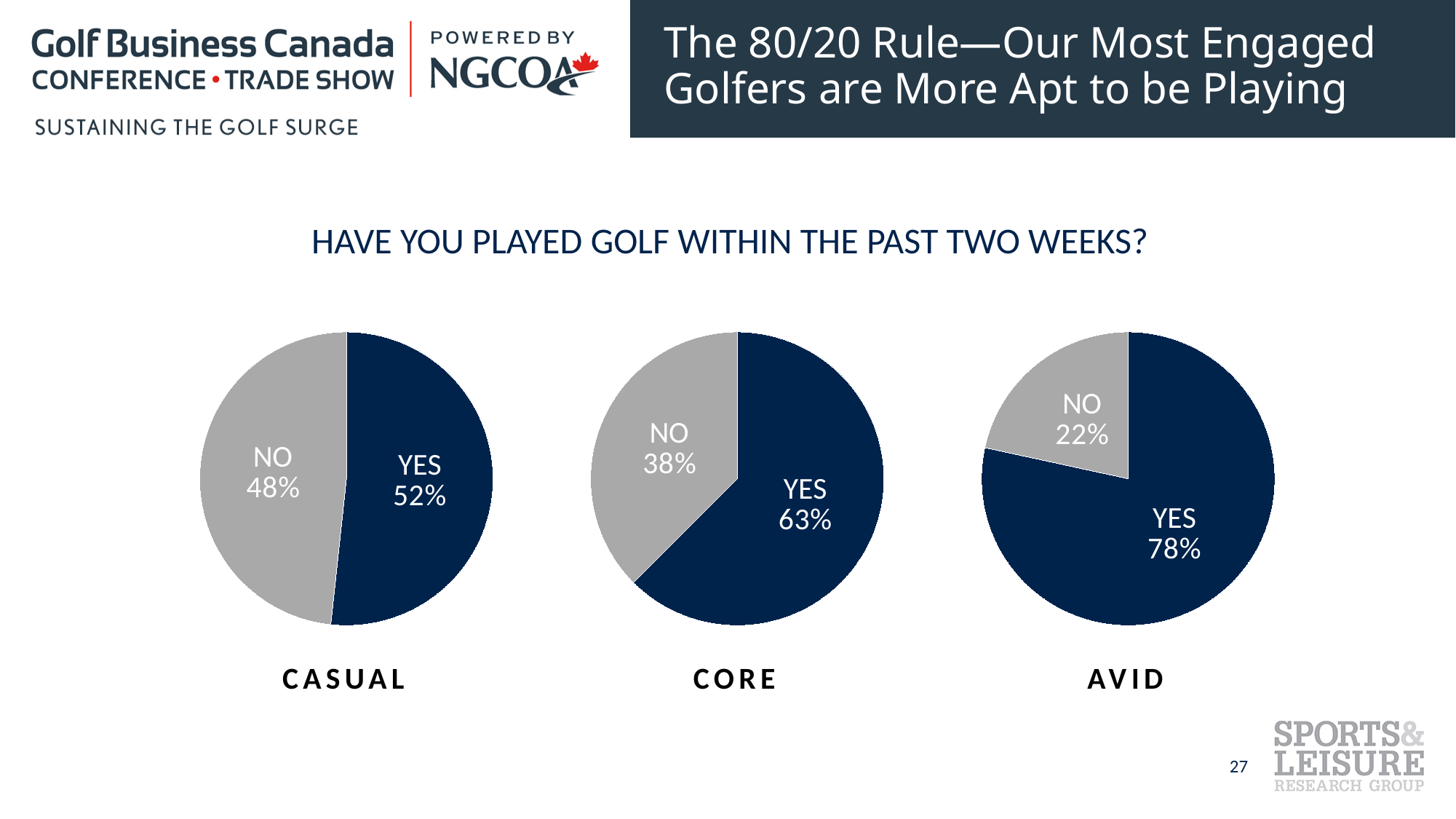
How many pie charts are shown on the slide? 3 What is the difference between the YES share in the AVID pie chart and the YES share in the CASUAL pie chart? 26 percentage points In the CORE pie chart, what percentage answered NO? 38% Which is larger: the NO share in the CASUAL pie chart or the NO share in the CORE pie chart? NO share in the CASUAL pie chart What question do the pie charts on this slide answer? HAVE YOU PLAYED GOLF WITHIN THE PAST TWO WEEKS? Across the three pie charts, which golfer segment has the lowest YES share? CASUAL In the CASUAL pie chart, what percentage answered YES? 52% Across the three pie charts, which golfer segment has the highest YES share? AVID What type of chart is used on this slide? Pie chart In the AVID pie chart, what percentage answered YES? 78% In the AVID pie chart, what percentage answered NO? 22% In the CORE pie chart, what is the difference between the YES and NO shares? 25 percentage points